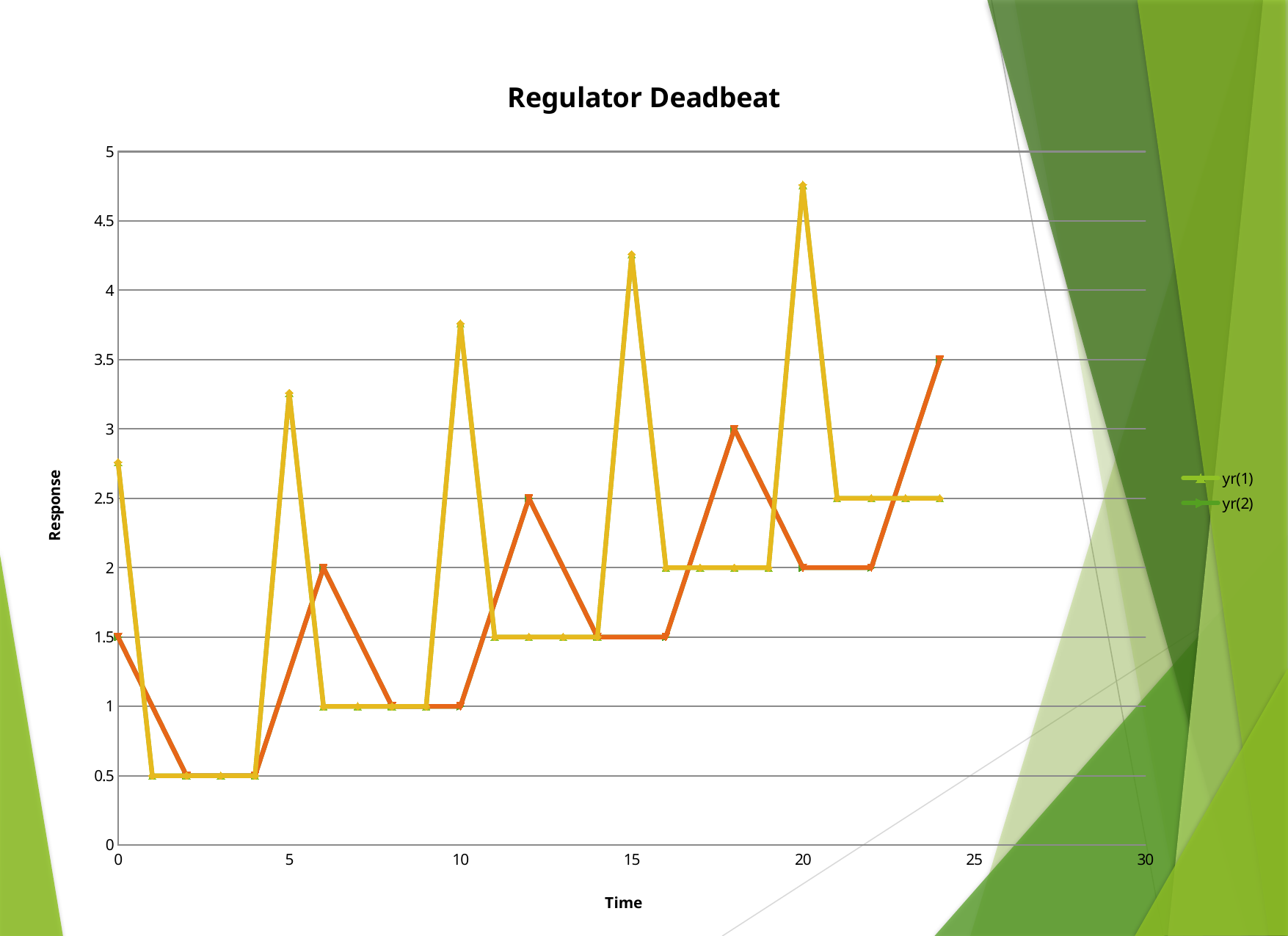
What is the title of the chart? Regulator Deadbeat Is the value of yr(1) at Time 20 greater or less than 4.5? greater What is the value of yr(1) at Time 22? 2.5 At Time 12, which series has the higher value, yr(1) or yr(2)? yr(2) What kind of chart is shown on the slide? line chart Which series reaches the highest value on the chart? yr(1) What is the value of yr(1) at Time 2? 0.5 What is the value of yr(2) at Time 0? 1.5 What is the label of the vertical axis? Response What is the value of yr(2) at Time 6? 2 How many series does the legend list? 2 What is the value of yr(2) at Time 24? 3.5